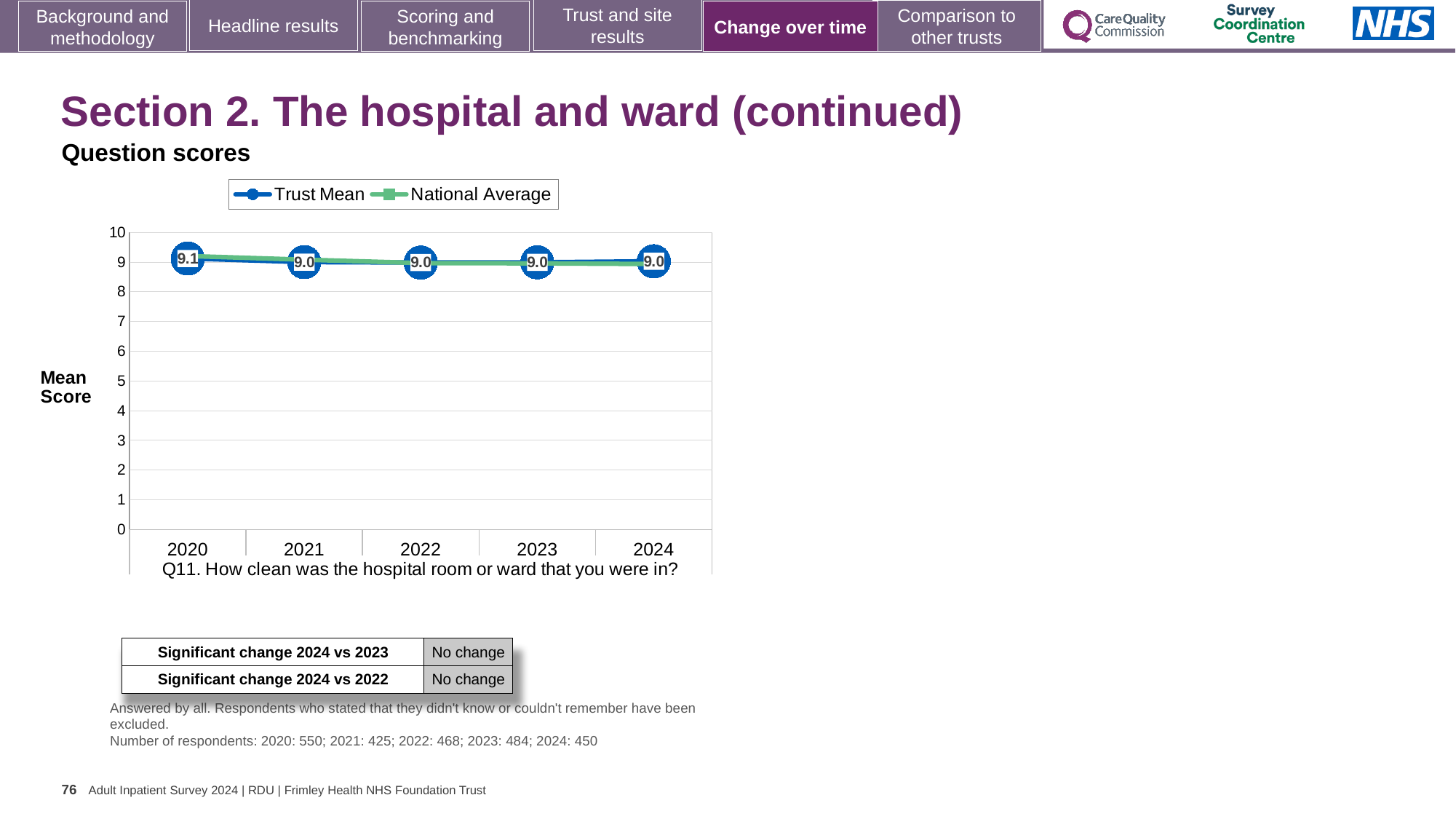
What is the Trust Mean score for 2020 on the Q11 chart? 9.1 What is the difference between the Trust Mean score in 2020 and in 2024? 0.1 Is the Trust Mean score for 2020 larger or smaller than the Trust Mean score for 2021? larger What is the Trust Mean score for 2024 on the Q11 chart? 9.0 Does the Trust Mean score rise or fall from 2020 to 2021? fall In which year is the Trust Mean score highest on the Q11 chart? 2020 What kind of chart is shown on the slide? line chart How many years are shown on the x axis of the chart? 5 Which survey question does the chart show scores for? Q11. How clean was the hospital room or ward that you were in? What is the Trust Mean score for 2022 on the Q11 chart? 9.0 How many series does the chart legend list? 2 Is the National Average value for 2023 greater or less than 8? greater